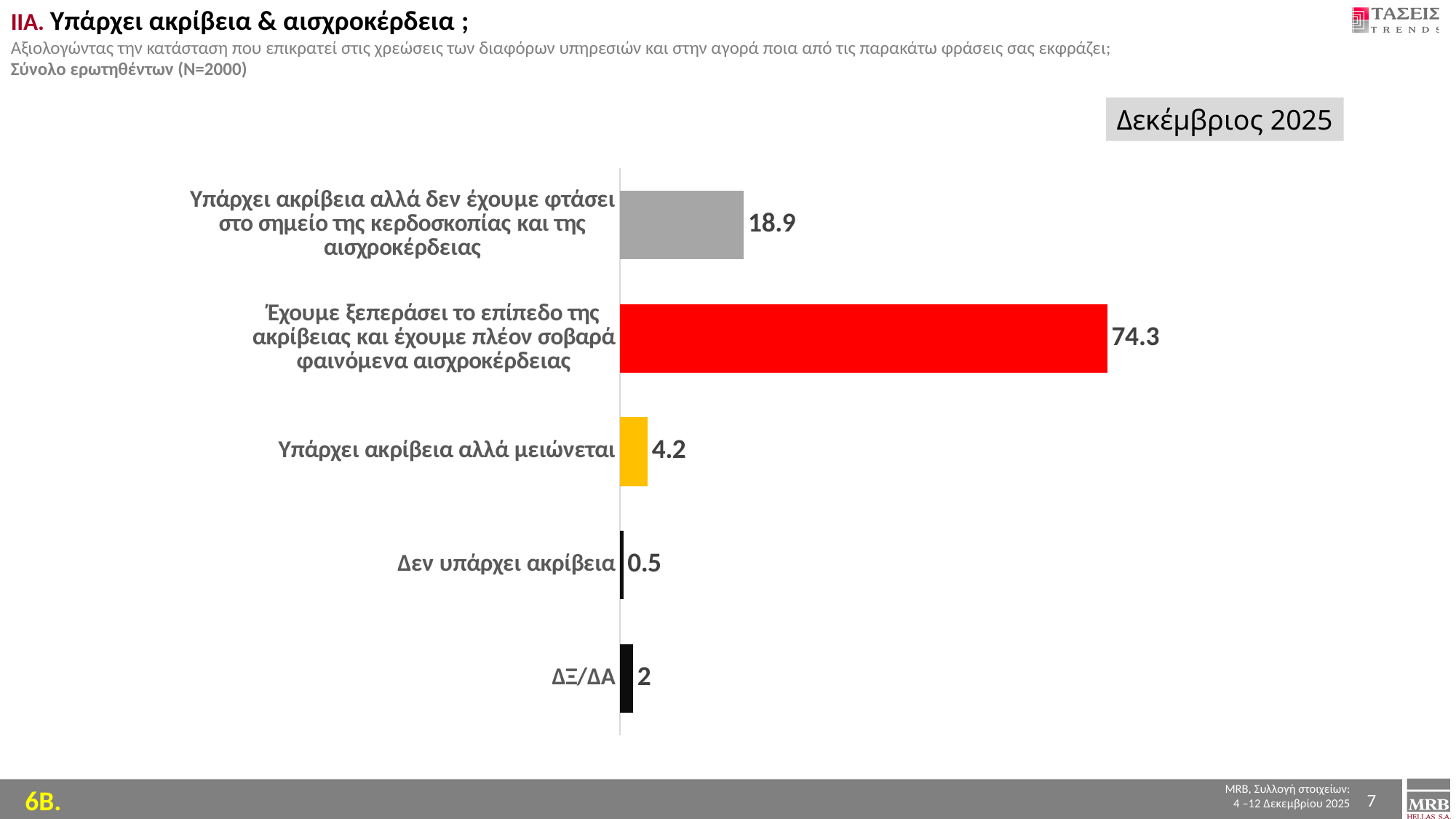
Which is larger: the value for "Υπάρχει ακρίβεια αλλά μειώνεται" or the value for "ΔΞ/ΔΑ"? Υπάρχει ακρίβεια αλλά μειώνεται What is the difference between the values for "Έχουμε ξεπεράσει το επίπεδο της ακρίβειας..." and "Υπάρχει ακρίβεια αλλά δεν έχουμε φτάσει στο σημείο της κερδοσκοπίας..."? 55.4 Which category has the highest value? Έχουμε ξεπεράσει το επίπεδο της ακρίβειας και έχουμε πλέον σοβαρά φαινόμενα αισχροκέρδειας Which category has the lowest value? Δεν υπάρχει ακρίβεια What is the value for "Δεν υπάρχει ακρίβεια"? 0.5 How many categories are shown in the chart? 5 What is the value for "Υπάρχει ακρίβεια αλλά δεν έχουμε φτάσει στο σημείο της κερδοσκοπίας και της αισχροκέρδειας"? 18.9 What is the value for "Έχουμε ξεπεράσει το επίπεδο της ακρίβειας και έχουμε πλέον σοβαρά φαινόμενα αισχροκέρδειας"? 74.3 What is the value for "ΔΞ/ΔΑ"? 2 What is the value for "Υπάρχει ακρίβεια αλλά μειώνεται"? 4.2 What kind of chart is shown on the slide? Bar chart What colour is the bar for "Έχουμε ξεπεράσει το επίπεδο της ακρίβειας και έχουμε πλέον σοβαρά φαινόμενα αισχροκέρδειας"? Red